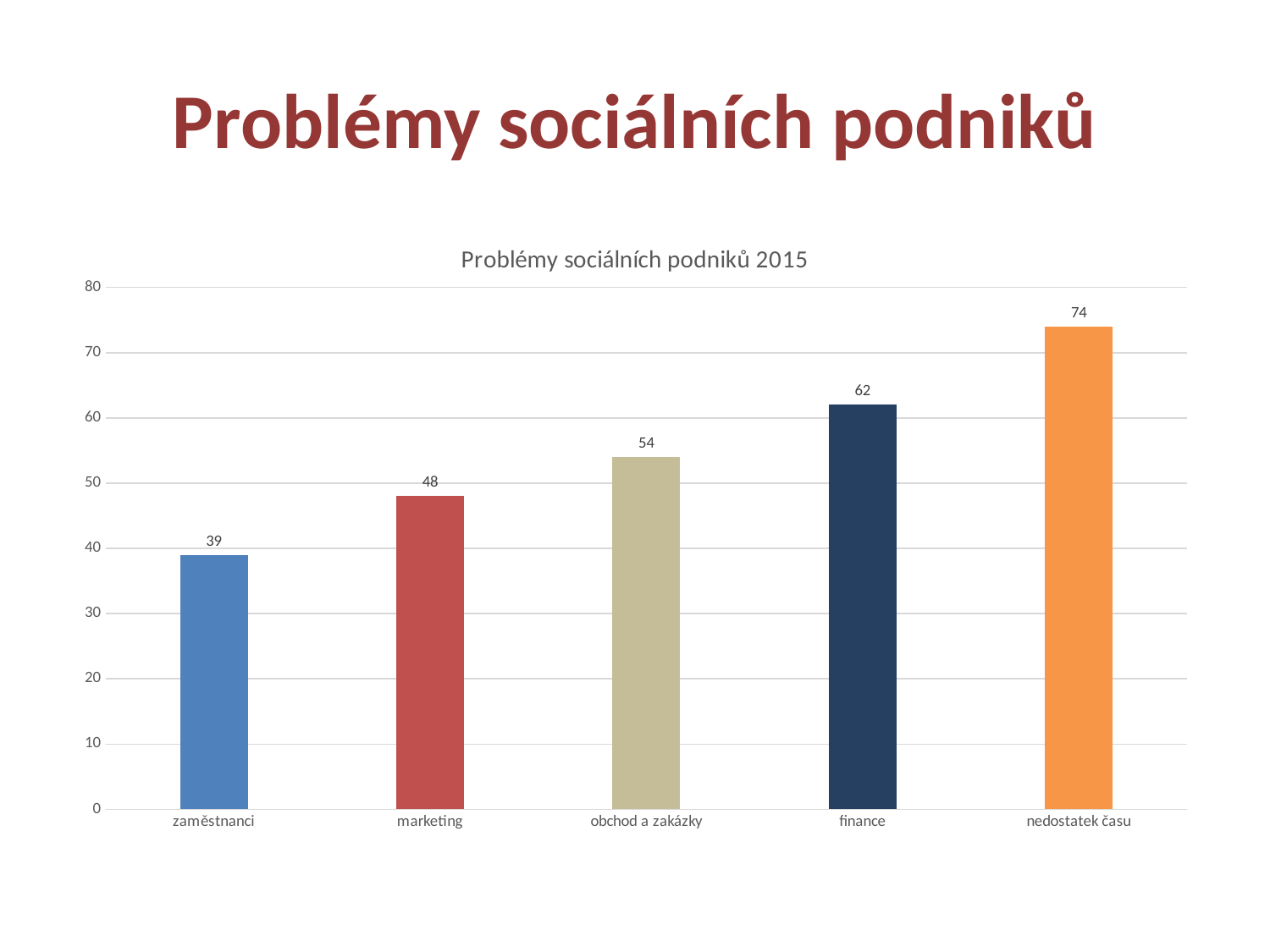
Which category has the lowest value? zaměstnanci What is the title of the chart? Problémy sociálních podniků 2015 How many categories are shown on the x axis? 5 Which category has the highest value? nedostatek času What is the value for marketing? 48 What is the value for finance? 62 Which is larger, the value for marketing or the value for obchod a zakázky? obchod a zakázky What is the difference between the values for nedostatek času and zaměstnanci? 35 Is the value for finance greater or less than 60? greater What is the difference between the values for finance and obchod a zakázky? 8 What kind of chart is shown on the slide? bar chart What is the value for zaměstnanci? 39